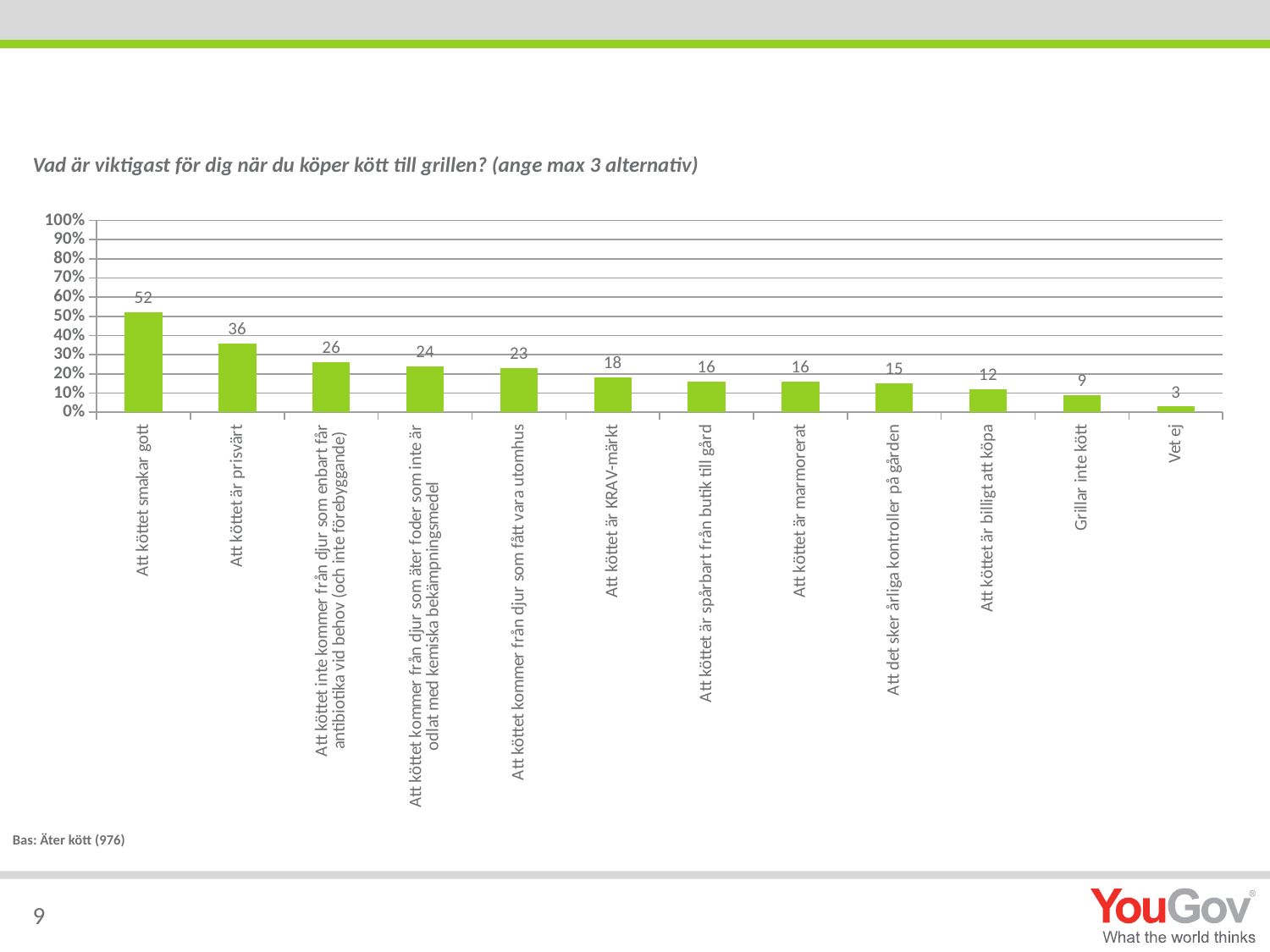
Which category has the highest value? Att köttet smakar gott Which category has the lowest value? Vet ej Is the value for "Att köttet är prisvärt" greater or less than 30%? greater What is the title of the chart? Vad är viktigast för dig när du köper kött till grillen? (ange max 3 alternativ) What is the value for "Grillar inte kött"? 9 Do the values rise or fall from left to right along the x axis? Fall Which is larger, the value for "Att köttet är billigt att köpa" or the value for "Att det sker årliga kontroller på gården"? Att det sker årliga kontroller på gården What is the difference between the values for "Att köttet smakar gott" and "Att köttet är prisvärt"? 16 What is the value for "Att köttet är KRAV-märkt"? 18 How many categories are shown in the chart? 12 What kind of chart is shown on the slide? Bar chart What is the value for "Att köttet smakar gott"? 52